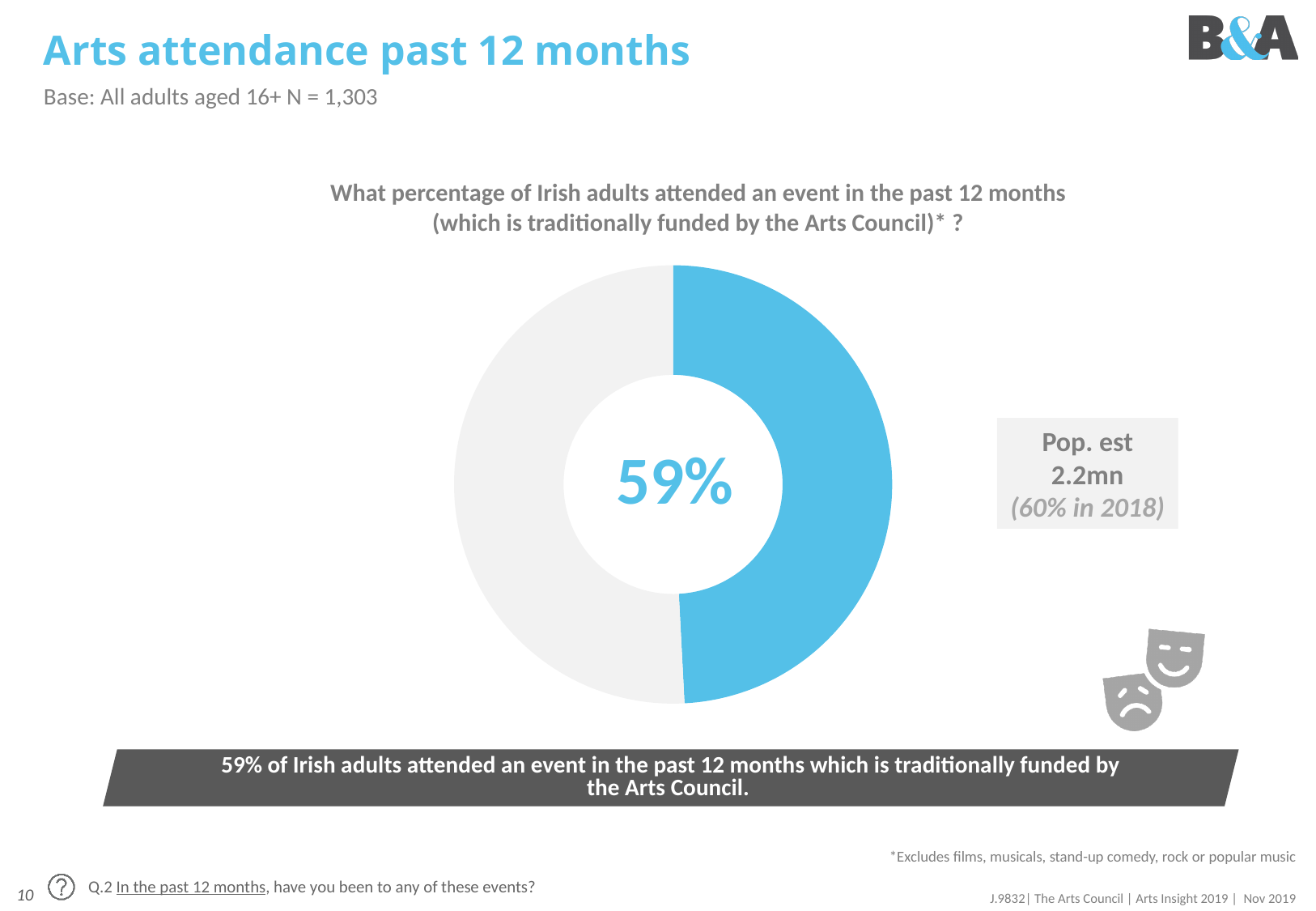
What was the attendance percentage in 2018, as noted beside the chart? 60% What share of the donut chart does the blue segment represent? 59% Is the value shown in the centre of the donut chart greater or less than 50%? greater What percentage of Irish adults attended an Arts Council-funded event in the past 12 months, according to the chart? 59% Is the grey segment of the donut chart greater or less than 50%? less By how many percentage points did attendance change from 2018 (60%) to the 59% shown in the chart? 1 percentage point lower What is the population estimate shown beside the chart? 2.2mn What kind of chart is shown on the slide? Donut (pie) chart What is the sample size (N) stated in the base for the chart? 1,303 Which segment of the donut chart is larger, the blue one or the grey one? The blue one How many segments does the donut chart have? 2 What is the title of the slide containing the chart? Arts attendance past 12 months